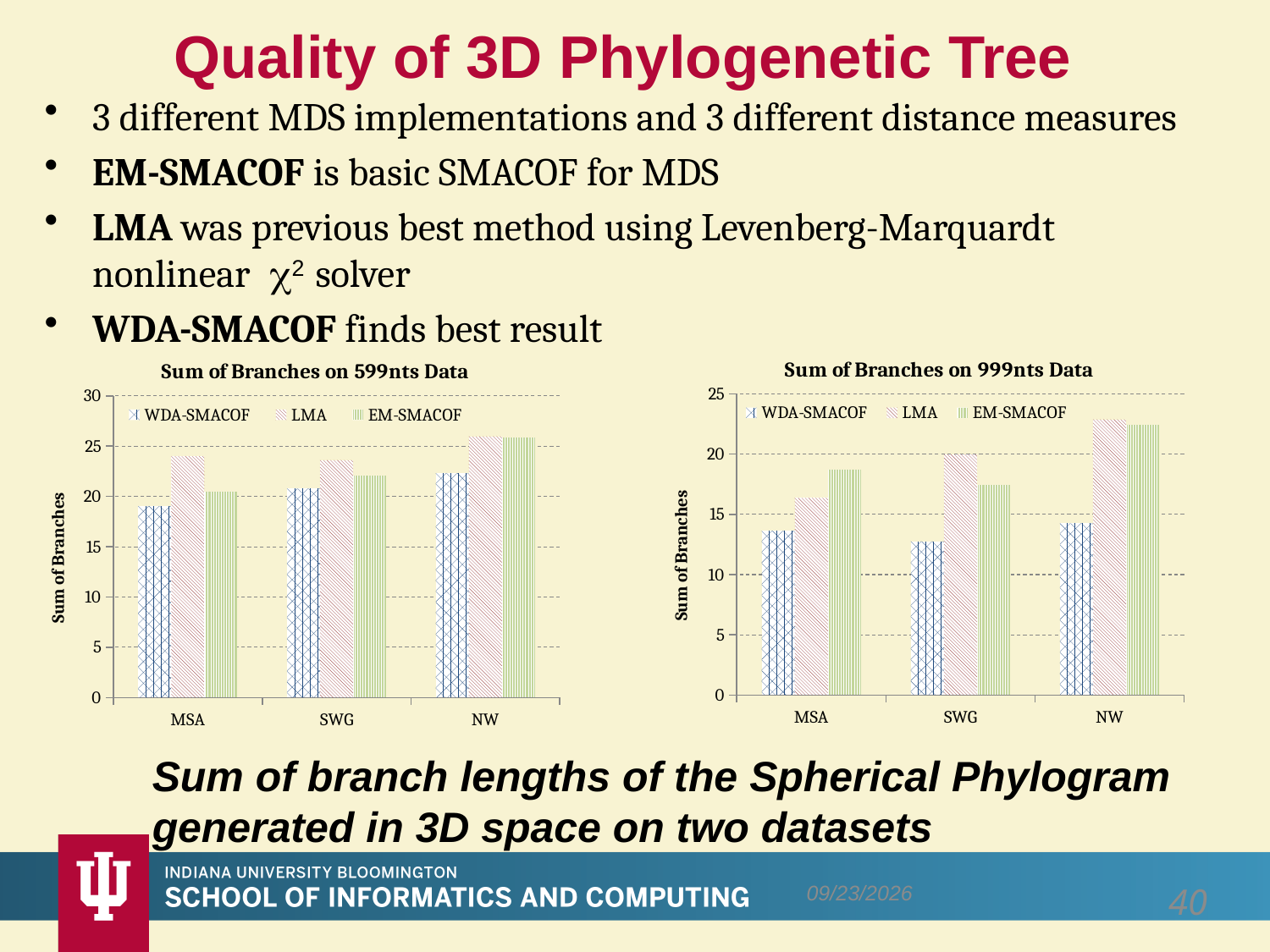
In "Sum of Branches on 999nts Data", which is larger at SWG: LMA or EM-SMACOF? LMA In "Sum of Branches on 999nts Data", is the value for WDA-SMACOF at SWG greater or less than 15? less In "Sum of Branches on 599nts Data", which category has the highest WDA-SMACOF value? NW In "Sum of Branches on 599nts Data", which is larger at MSA: LMA or WDA-SMACOF? LMA What kind of chart is "Sum of Branches on 599nts Data"? bar chart How many series does the legend of "Sum of Branches on 999nts Data" list? 3 In "Sum of Branches on 599nts Data", is the value for WDA-SMACOF at MSA greater or less than 20? less In "Sum of Branches on 999nts Data", is the value for LMA at NW greater or less than 20? greater How many categories are shown on the x axis of "Sum of Branches on 599nts Data"? 3 What is the y-axis label of the chart on the right? Sum of Branches In "Sum of Branches on 999nts Data", which series has the lowest value at MSA? WDA-SMACOF